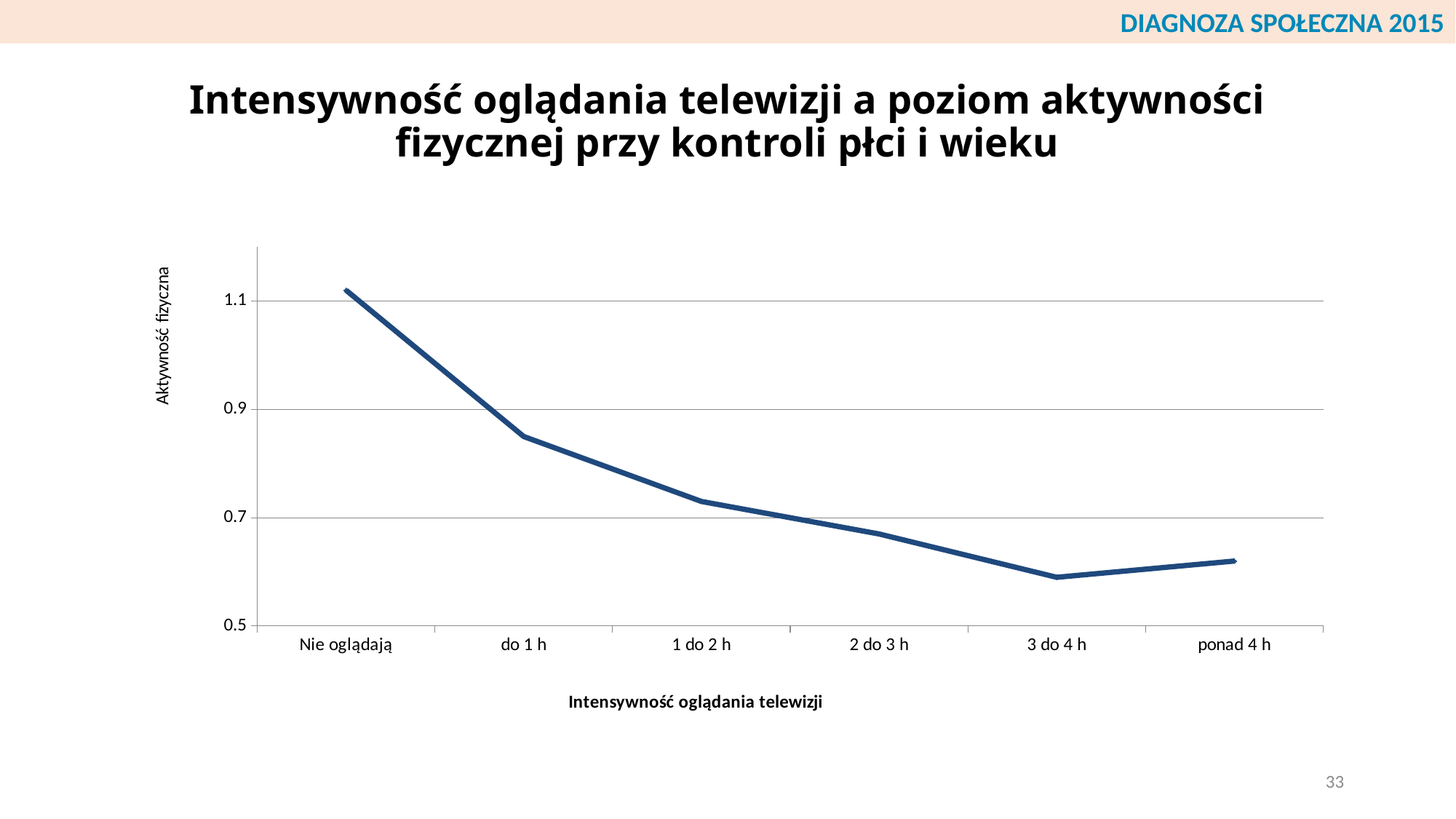
Is the value for 'Nie oglądają' greater or less than 0.9? greater Does physical activity generally rise or fall as television watching intensity increases from 'Nie oglądają' to '3 do 4 h'? fall What is the label of the y axis of the chart? Aktywność fizyczna Is the value for 'do 1 h' greater or less than 0.9? less Which category has the highest level of physical activity (Aktywność fizyczna)? Nie oglądają Is the value for 'ponad 4 h' greater or less than 0.7? less What kind of chart is shown on the slide? line chart Which has a higher value: 'Nie oglądają' or 'do 1 h'? Nie oglądają How many categories are shown on the x axis of the chart? 6 Which category has the lowest level of physical activity (Aktywność fizyczna)? 3 do 4 h What is the label of the x axis of the chart? Intensywność oglądania telewizji